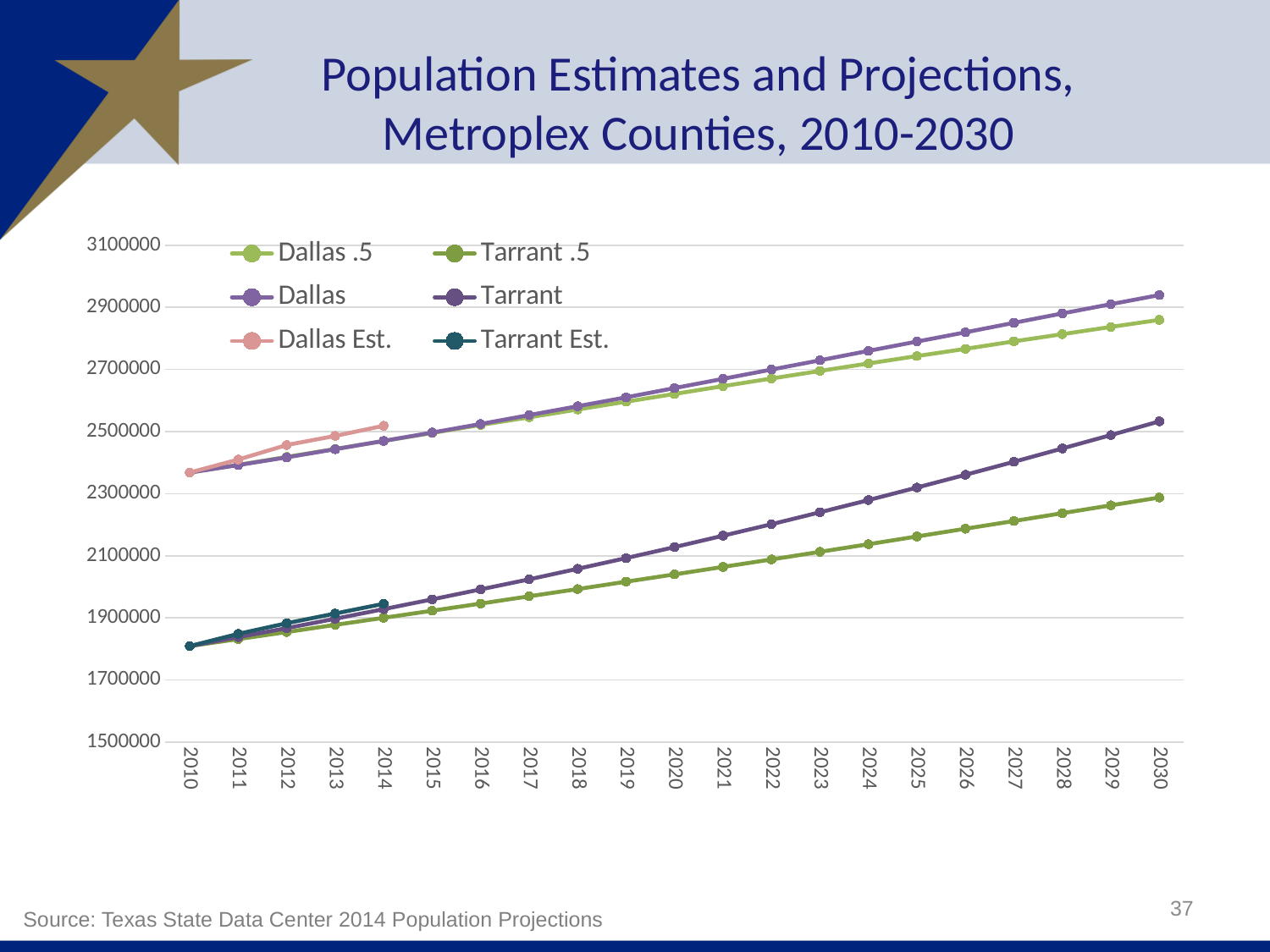
How many years are shown along the x axis? 21 Does the Dallas series rise or fall from 2010 to 2030? rise Which series has the lowest value in 2030? Tarrant .5 In 2030, which is larger, Tarrant or Tarrant .5? Tarrant Is the value for Dallas in 2030 greater or less than 2700000? greater Is the value for Tarrant in 2010 greater or less than 1900000? less What is the title of the chart? Population Estimates and Projections, Metroplex Counties, 2010-2030 Which series has the highest value in 2030? Dallas Is the value for Dallas in 2010 greater or less than 2300000? greater How many series does the legend list? 6 In 2030, which is larger, Dallas or Tarrant? Dallas What kind of chart is shown on the slide? line chart